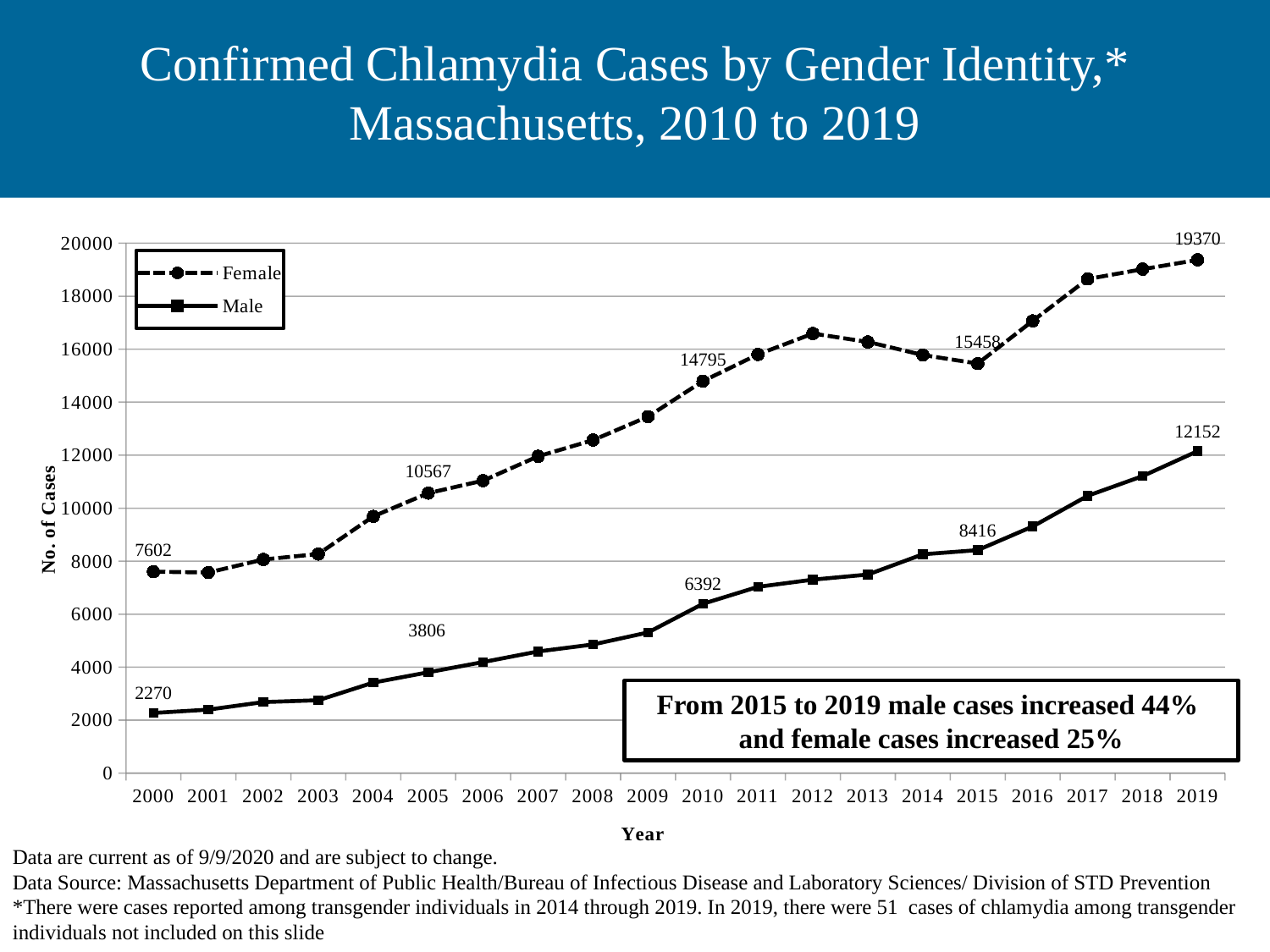
Do male cases generally rise or fall from 2000 to 2019? rise Is the value for female cases in 2012 greater or less than 16000? greater What was the number of female cases in 2010? 14795 What was the number of confirmed chlamydia cases among males in 2000? 2270 What kind of chart is shown on the slide? line chart How many series does the legend list? 2 What was the number of confirmed chlamydia cases among females in 2019? 19370 Which series had more cases in 2019, Female or Male? Female How many years are plotted along the x axis? 20 What was the number of male cases in 2015? 8416 By how much did male cases increase from 2015 to 2019? 3736 What is the difference between female and male cases in 2005? 6761